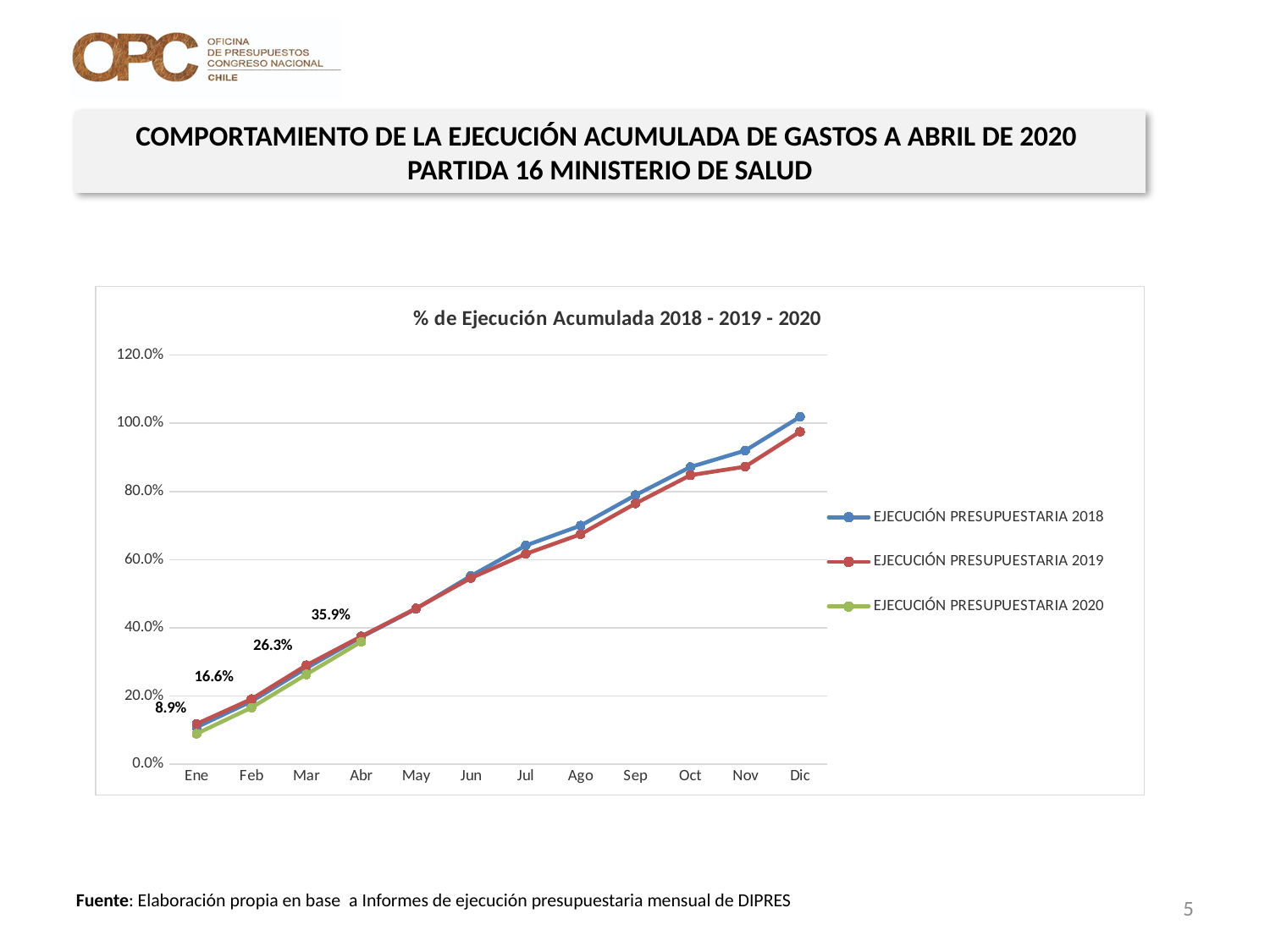
Is the value for EJECUCIÓN PRESUPUESTARIA 2018 in Dic greater or less than 100.0%? greater Is the value for EJECUCIÓN PRESUPUESTARIA 2019 in Dic greater or less than 100.0%? less In which month does EJECUCIÓN PRESUPUESTARIA 2020 reach its highest value? Abr What is the difference between the EJECUCIÓN PRESUPUESTARIA 2020 values for Abr and Mar? 9.6 percentage points Do the values for EJECUCIÓN PRESUPUESTARIA 2018 rise or fall from Ene to Dic? Rise How many series does the legend list? 3 What is the value for EJECUCIÓN PRESUPUESTARIA 2020 in Mar? 26.3% What kind of chart is shown? Line chart Which is larger in Dic: EJECUCIÓN PRESUPUESTARIA 2018 or EJECUCIÓN PRESUPUESTARIA 2019? EJECUCIÓN PRESUPUESTARIA 2018 How many months are shown on the x axis? 12 What is the value for EJECUCIÓN PRESUPUESTARIA 2020 in Ene? 8.9% What is the value for EJECUCIÓN PRESUPUESTARIA 2020 in Abr? 35.9%